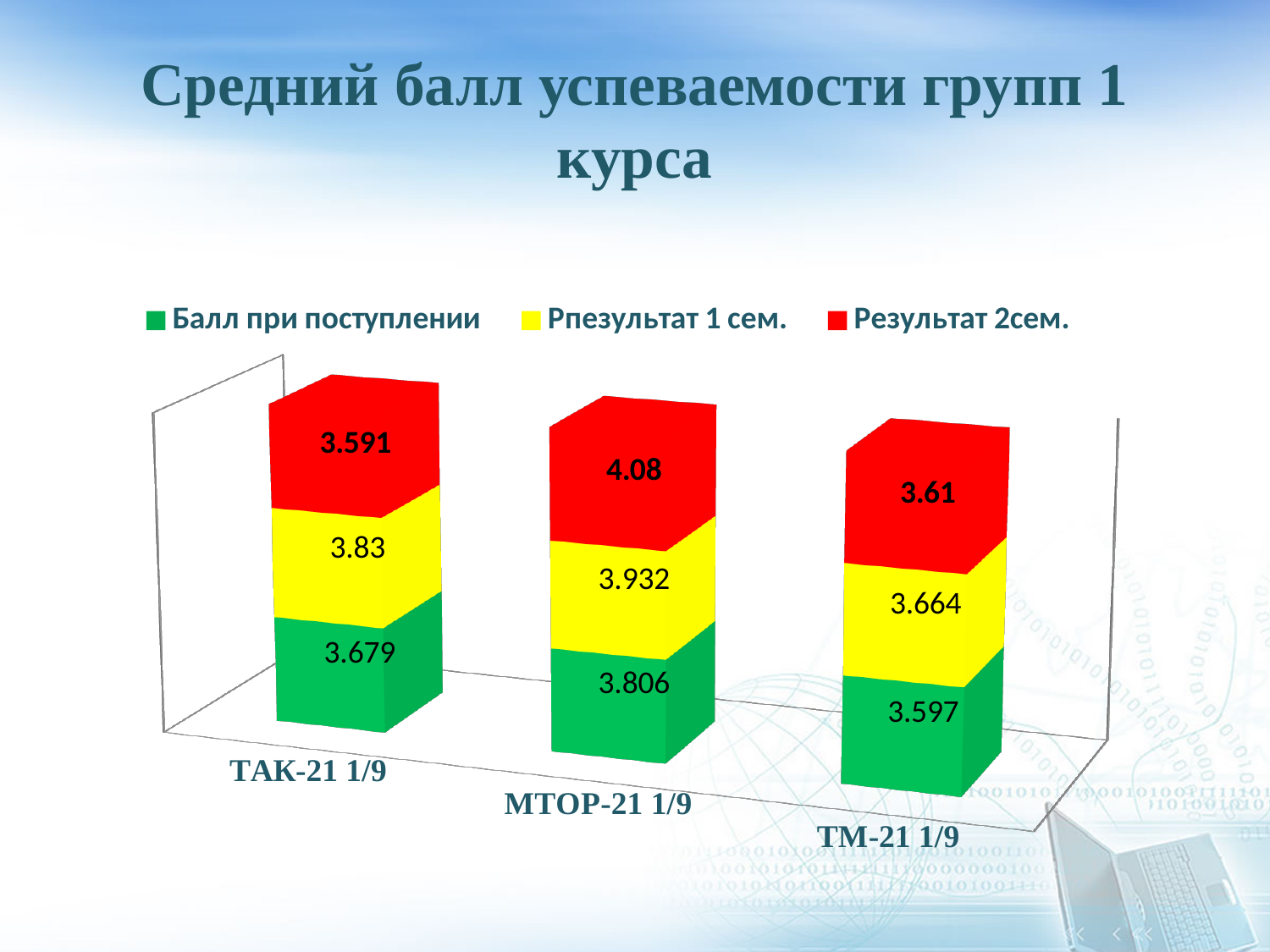
How many groups are shown on the x axis? 3 What is the value of Балл при поступлении for ТАК-21 1/9? 3.679 Which colour represents Рпезультат 1 сем. in the chart? Yellow What is the total of the stacked bar for МТОР-21 1/9? 11.818 What is the difference between the Результат 2сем. values for МТОР-21 1/9 and ТАК-21 1/9? 0.489 How many series does the legend list? 3 Which is larger: Балл при поступлении for ТАК-21 1/9 or for ТМ-21 1/9? ТАК-21 1/9 What kind of chart is shown on the slide? Stacked bar chart What is the value of Рпезультат 1 сем. for ТМ-21 1/9? 3.664 Which group has the highest value for Результат 2сем.? МТОР-21 1/9 Which group has the lowest value for Балл при поступлении? ТМ-21 1/9 What is the value of Результат 2сем. for МТОР-21 1/9? 4.08